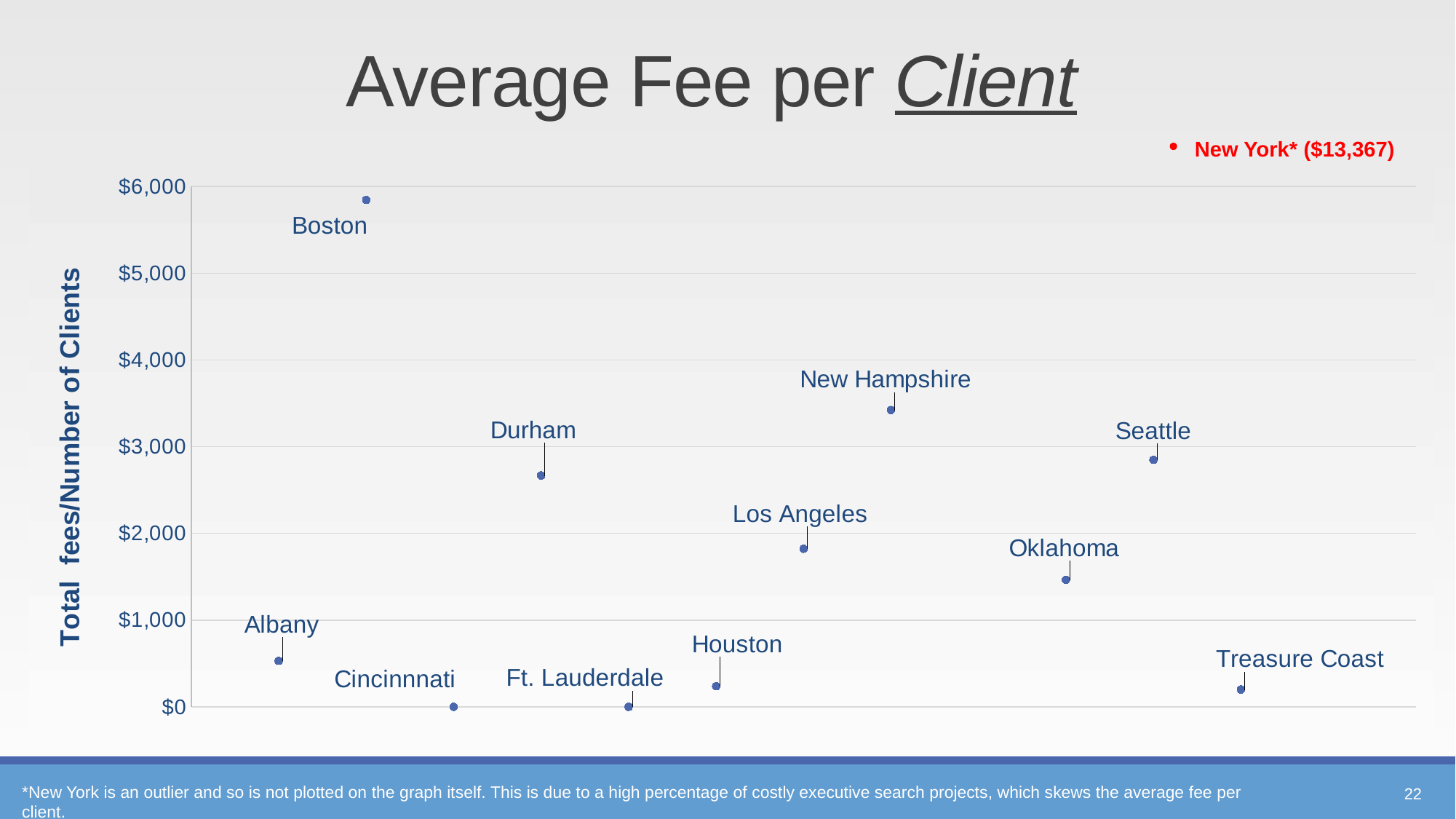
Which has a higher average fee per client, Albany or Houston? Albany What is the title of the vertical axis? Total fees/Number of Clients Is the value for New Hampshire greater or less than $3,000? greater Is the value for Oklahoma greater or less than $1,000? greater Is the value for Los Angeles greater or less than $2,000? less How many cities are plotted as points on the chart? 11 Which plotted city has the highest average fee per client? Boston What kind of chart is shown on the slide? Scatter chart Which has a higher average fee per client, New Hampshire or Durham? New Hampshire